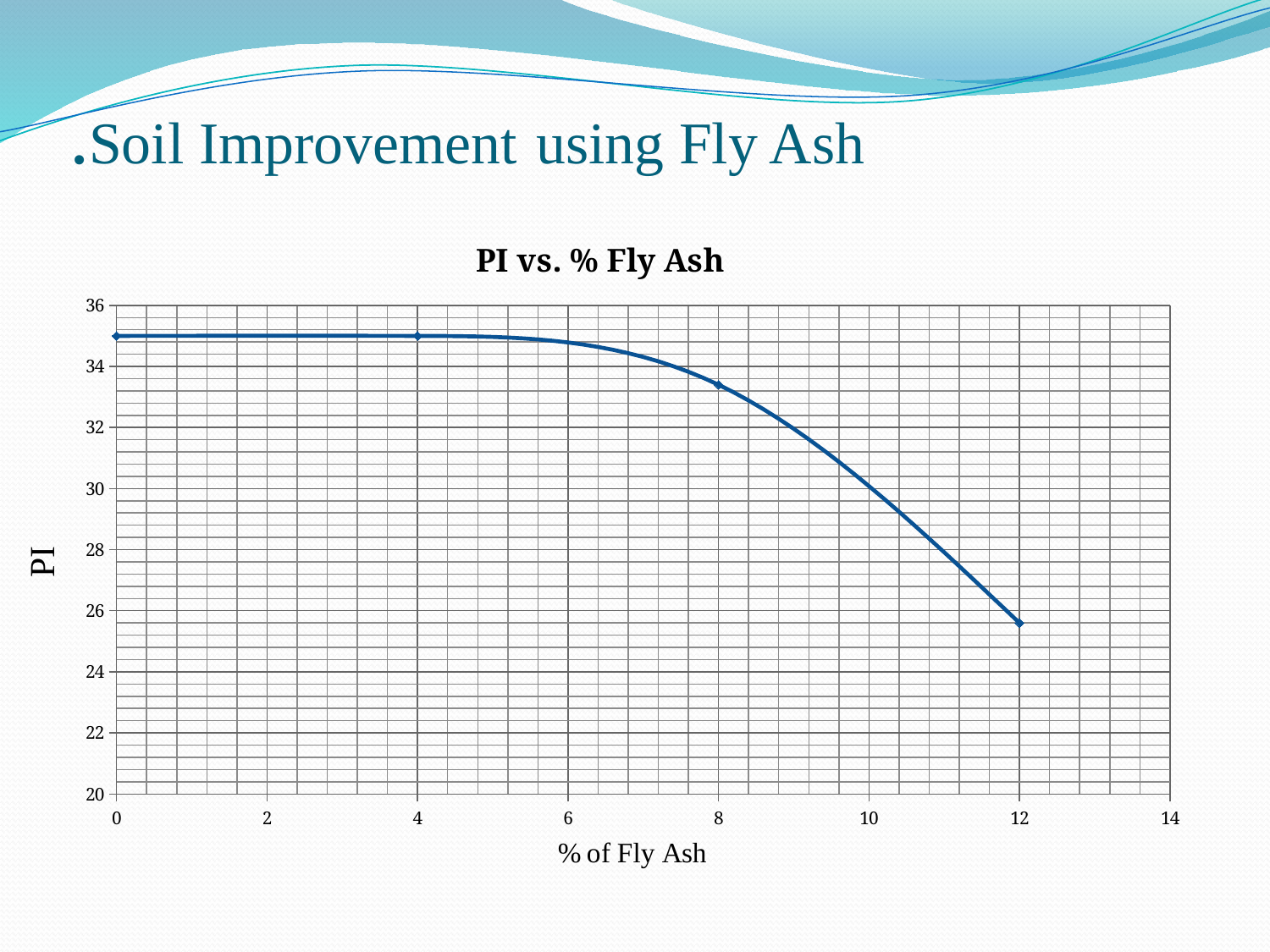
Is the PI value at 12% fly ash greater or less than 26? less What is the label of the x axis? % of Fly Ash At which % of Fly Ash is PI lowest? 12 What is the title of the chart? PI vs. % Fly Ash Does PI rise or fall as % of Fly Ash increases along the x axis? fall Which has the larger PI value: 8% fly ash or 12% fly ash? 8% fly ash Is the PI value at 12% fly ash greater or less than 24? greater What kind of chart is shown on the slide? line chart Which has the larger PI value: 4% fly ash or 8% fly ash? 4% fly ash How many data points are plotted on the line? 4 Is the PI value at 8% fly ash greater or less than 32? greater